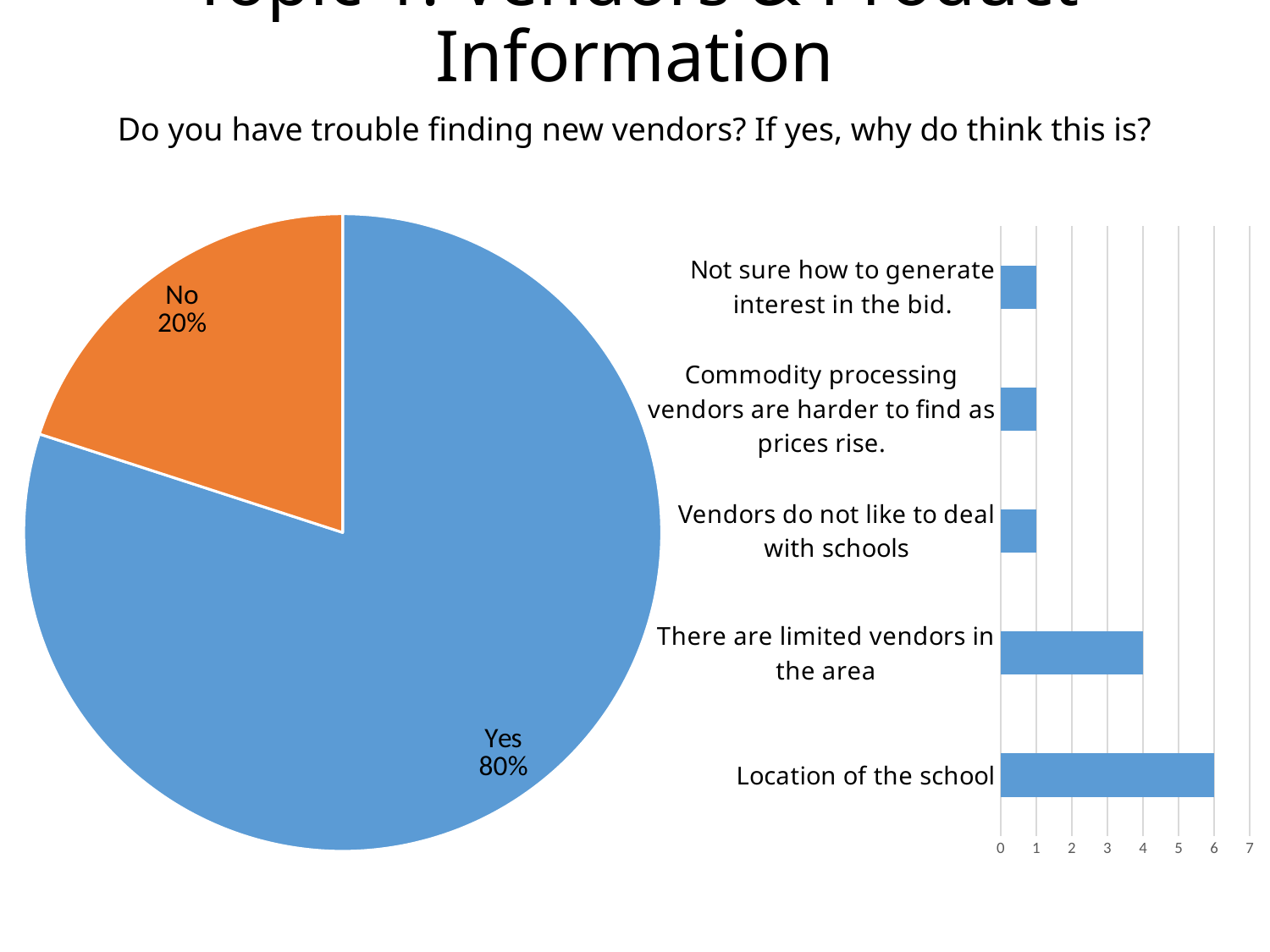
In the bar chart on the right, what is the difference between Location of the school and There are limited vendors in the area? 2 In the bar chart on the right, which category has the highest value? Location of the school In the bar chart on the right, what is the value for Location of the school? 6 In the pie chart on the left, what colour is the No slice? orange What kind of chart is on the right of the slide? bar chart In the bar chart on the right, how many categories are shown? 5 In the bar chart on the right, which is larger: There are limited vendors in the area or Not sure how to generate interest in the bid.? There are limited vendors in the area In the pie chart on the left, what share of respondents answered No? 20% What kind of chart is on the left of the slide? pie chart In the bar chart on the right, what is the value for Vendors do not like to deal with schools? 1 In the pie chart on the left, what share of respondents answered Yes? 80% In the bar chart on the right, what is the value for There are limited vendors in the area? 4